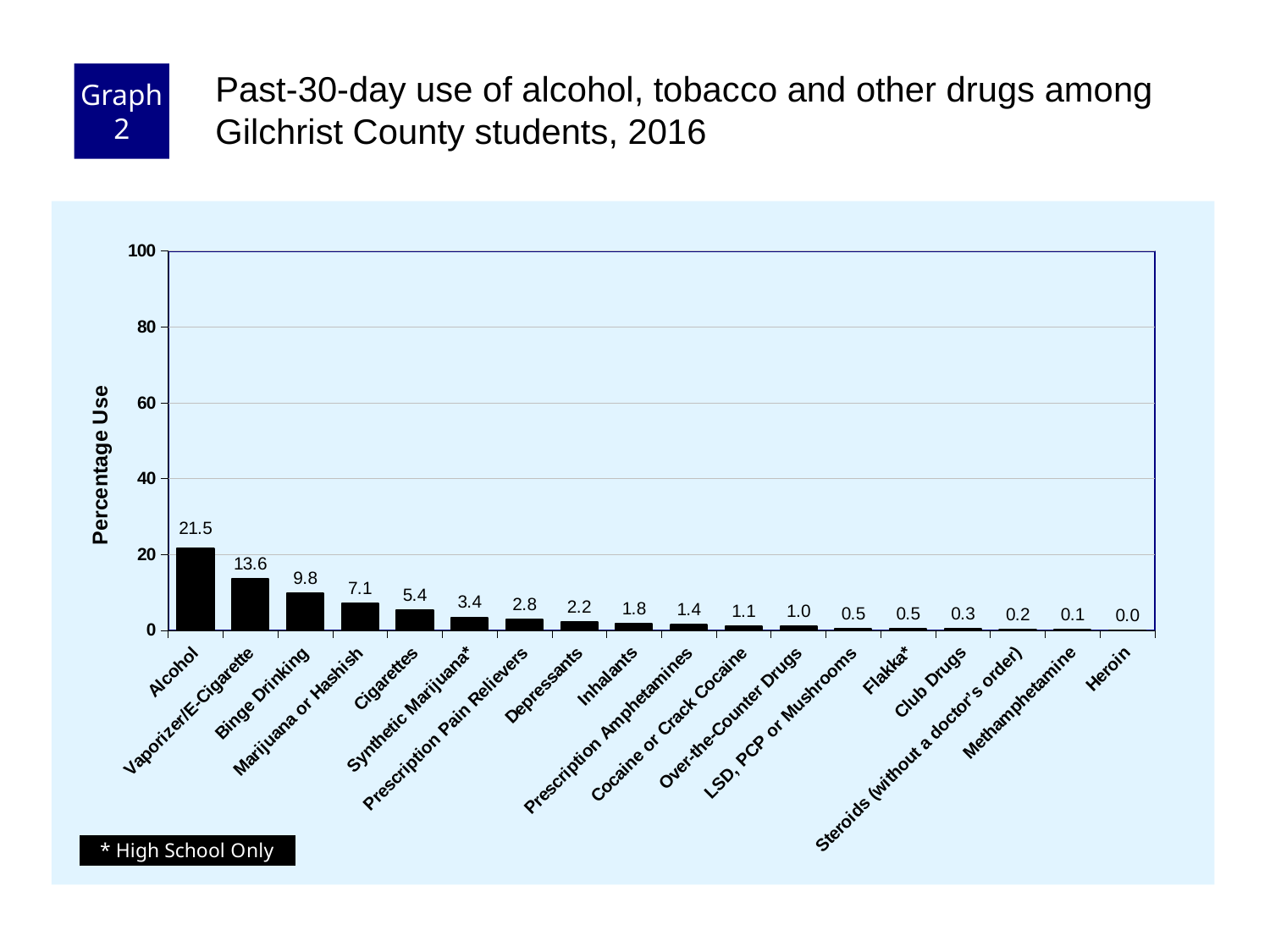
What is the percentage use for Binge Drinking? 9.8 What is the percentage use for Alcohol? 21.5 Which category has the lowest percentage use? Heroin What is the percentage use for Heroin? 0.0 What is the percentage use for Synthetic Marijuana*? 3.4 What is the difference in percentage use between Alcohol and Vaporizer/E-Cigarette? 7.9 Which has a higher percentage use, Cigarettes or Marijuana or Hashish? Marijuana or Hashish Is the value for Vaporizer/E-Cigarette greater or less than 20? less How many categories are shown on the x axis? 18 What kind of chart is shown on the slide? Bar chart What is the label of the y axis? Percentage Use Which category has the highest percentage use? Alcohol